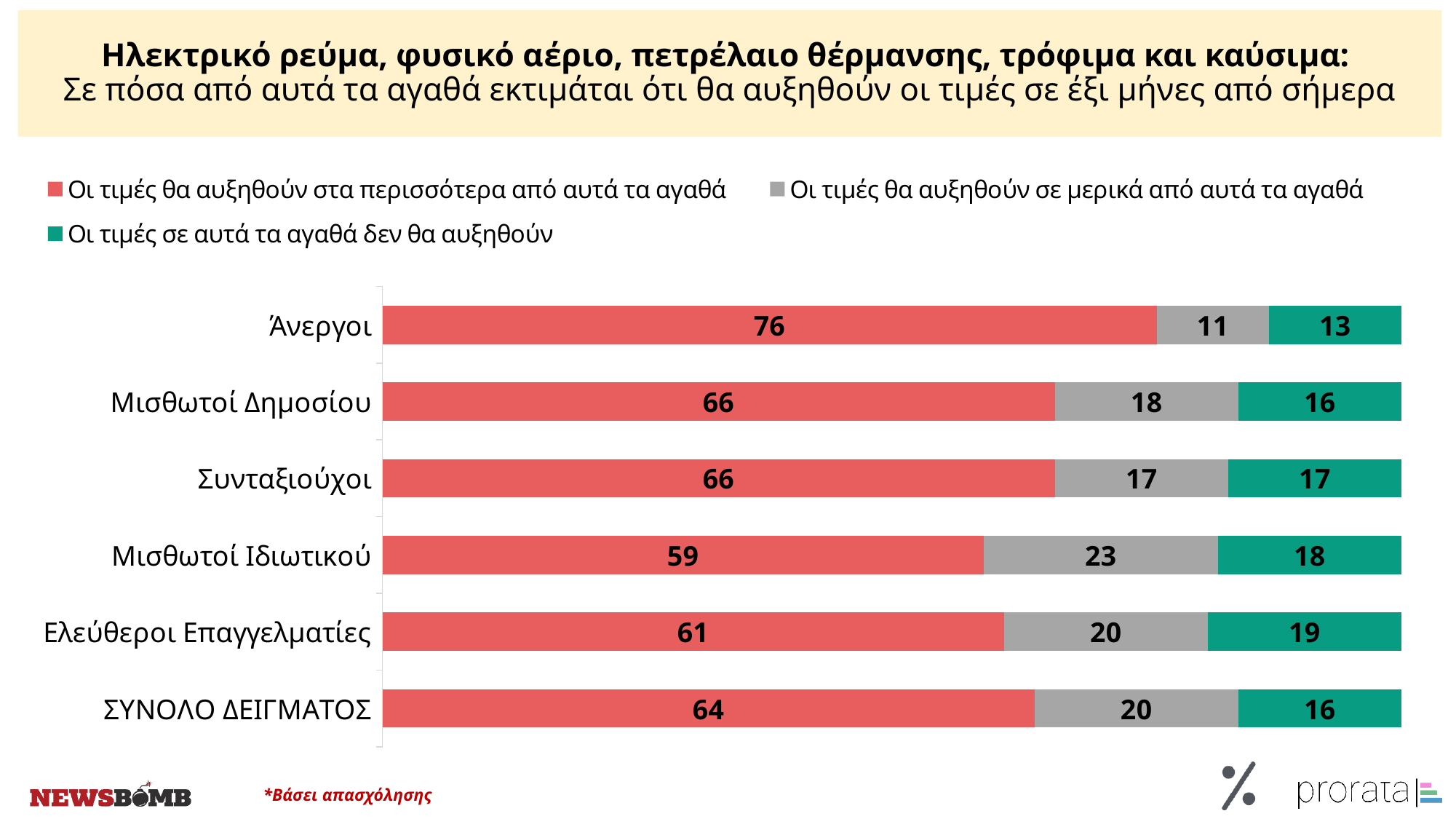
What is the total of the stacked bar for ΣΥΝΟΛΟ ΔΕΙΓΜΑΤΟΣ? 100 What kind of chart is shown on the slide? Stacked bar chart What is the value for Μισθωτοί Ιδιωτικού in the series 'Οι τιμές θα αυξηθούν σε μερικά από αυτά τα αγαθά'? 23 What is the difference between the 'Οι τιμές θα αυξηθούν στα περισσότερα από αυτά τα αγαθά' values for Άνεργοι and Μισθωτοί Ιδιωτικού? 17 Which category has the highest value in the series 'Οι τιμές θα αυξηθούν στα περισσότερα από αυτά τα αγαθά'? Άνεργοι How many series does the legend list? 3 What is the value for Ελεύθεροι Επαγγελματίες in the series 'Οι τιμές σε αυτά τα αγαθά δεν θα αυξηθούν'? 19 Which category has the lowest value in the series 'Οι τιμές θα αυξηθούν σε μερικά από αυτά τα αγαθά'? Άνεργοι How many categories are shown on the chart? 6 Which colour represents the series 'Οι τιμές σε αυτά τα αγαθά δεν θα αυξηθούν'? Green What is the value for Άνεργοι in the series 'Οι τιμές θα αυξηθούν στα περισσότερα από αυτά τα αγαθά'? 76 Which is larger: the 'Οι τιμές σε αυτά τα αγαθά δεν θα αυξηθούν' value for Μισθωτοί Ιδιωτικού or for Άνεργοι? Μισθωτοί Ιδιωτικού